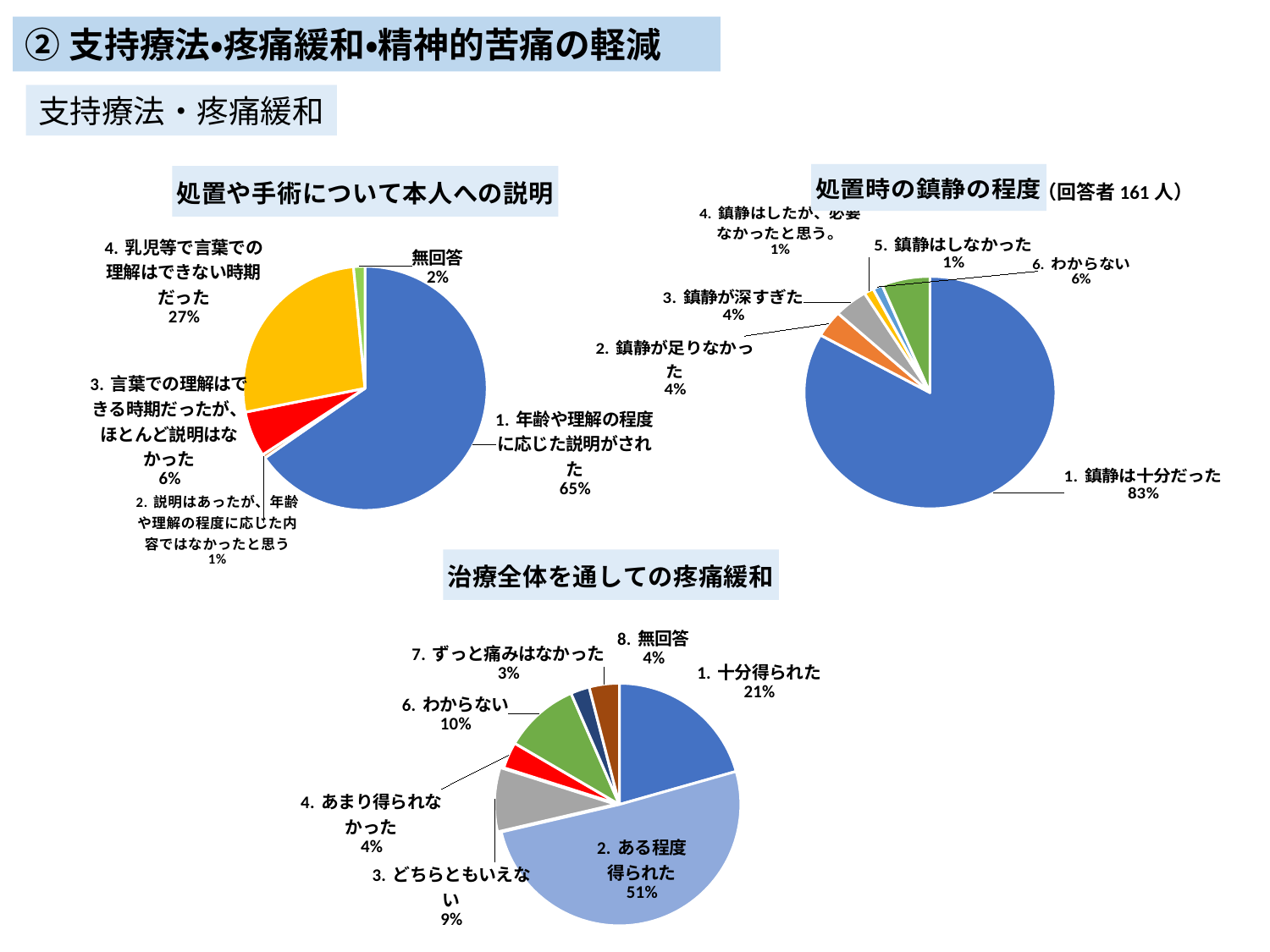
In the chart titled 治療全体を通しての疼痛緩和, which is larger: 6. わからない or 3. どちらともいえない? 6. わからない In the chart titled 処置や手術について本人への説明, which category has the smallest share? 2. 説明はあったが、年齢や理解の程度に応じた内容ではなかったと思う In the chart titled 処置時の鎮静の程度, what percentage is shown for 6. わからない? 6% In the chart titled 処置や手術について本人への説明, how many slices does the pie have? 5 In the chart titled 治療全体を通しての疼痛緩和, what percentage is shown for 2. ある程度得られた? 51% What type of chart is used for 治療全体を通しての疼痛緩和? Pie chart In the chart titled 処置時の鎮静の程度, what percentage is shown for 1. 鎮静は十分だった? 83% In the chart titled 処置時の鎮静の程度, how many slices does the pie have? 6 In the chart titled 処置や手術について本人への説明, what percentage is shown for 4. 乳児等で言葉での理解はできない時期だった? 27% In the chart titled 治療全体を通しての疼痛緩和, what is the difference in percentage points between 2. ある程度得られた and 1. 十分得られた? 30 In the chart titled 処置や手術について本人への説明, what percentage is shown for 1. 年齢や理解の程度に応じた説明がされた? 65% In the chart titled 処置時の鎮静の程度, how many respondents are stated in the title? 161人